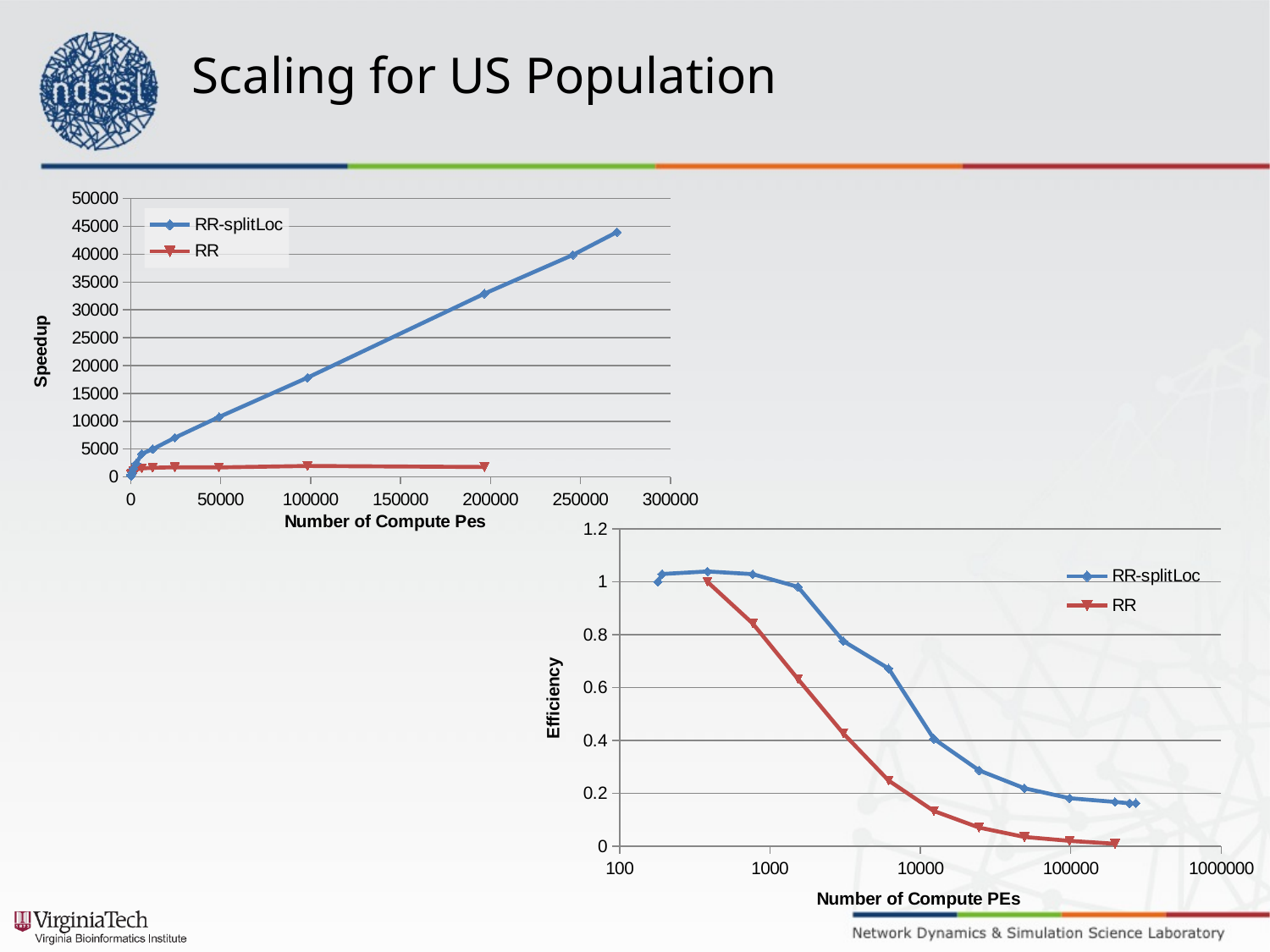
In the Speedup chart, is the speedup of RR at about 200000 compute PEs greater or less than 5000? less In the Speedup chart, is the speedup of RR-splitLoc at about 270000 compute PEs greater or less than 40000? greater In the Efficiency chart, which series has the higher efficiency at 10000 compute PEs, RR-splitLoc or RR? RR-splitLoc In the Speedup chart, which series reaches the higher speedup at the largest number of compute PEs, RR-splitLoc or RR? RR-splitLoc What is the label of the y axis of the bottom-right chart? Efficiency In the Efficiency chart, is the efficiency of RR at 100000 compute PEs greater or less than 0.2? less How many series does the legend of the Speedup chart list? 2 What kind of chart is the Efficiency chart at the bottom right of the slide? line chart In the Speedup chart, does the RR-splitLoc speedup rise or fall as the number of compute PEs increases? rise What kind of chart is the Speedup chart at the top left of the slide? line chart What is the label of the x axis of the Speedup chart? Number of Compute Pes In the Efficiency chart, does the efficiency of RR rise or fall as the number of compute PEs increases? fall